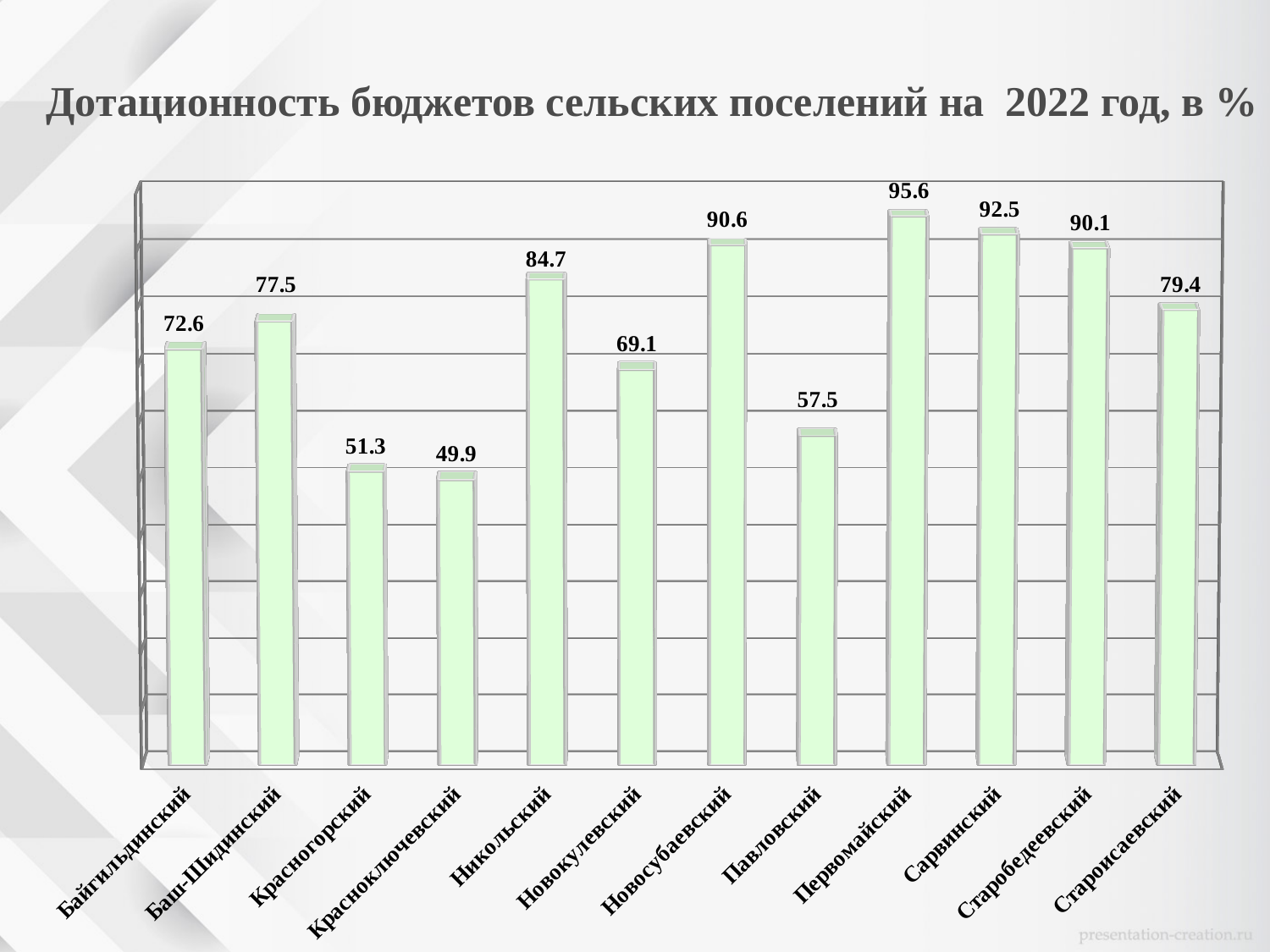
Which category has the lowest value? Красноключевский What is the difference between the values for Никольский and Новокулевский? 15.6 Which category has the highest value? Первомайский What is the value for Староисаевский? 79.4 What is the value for Красногорский? 51.3 What is the difference between the values for Первомайский and Красноключевский? 45.7 How many categories are shown on the chart? 12 What is the title of the chart? Дотационность бюджетов сельских поселений на 2022 год, в % Which is larger, the value for Сарвинский or the value for Новосубаевский? Сарвинский What is the value for Новокулевский? 69.1 What is the value for Первомайский? 95.6 What kind of chart is shown on the slide? Bar chart